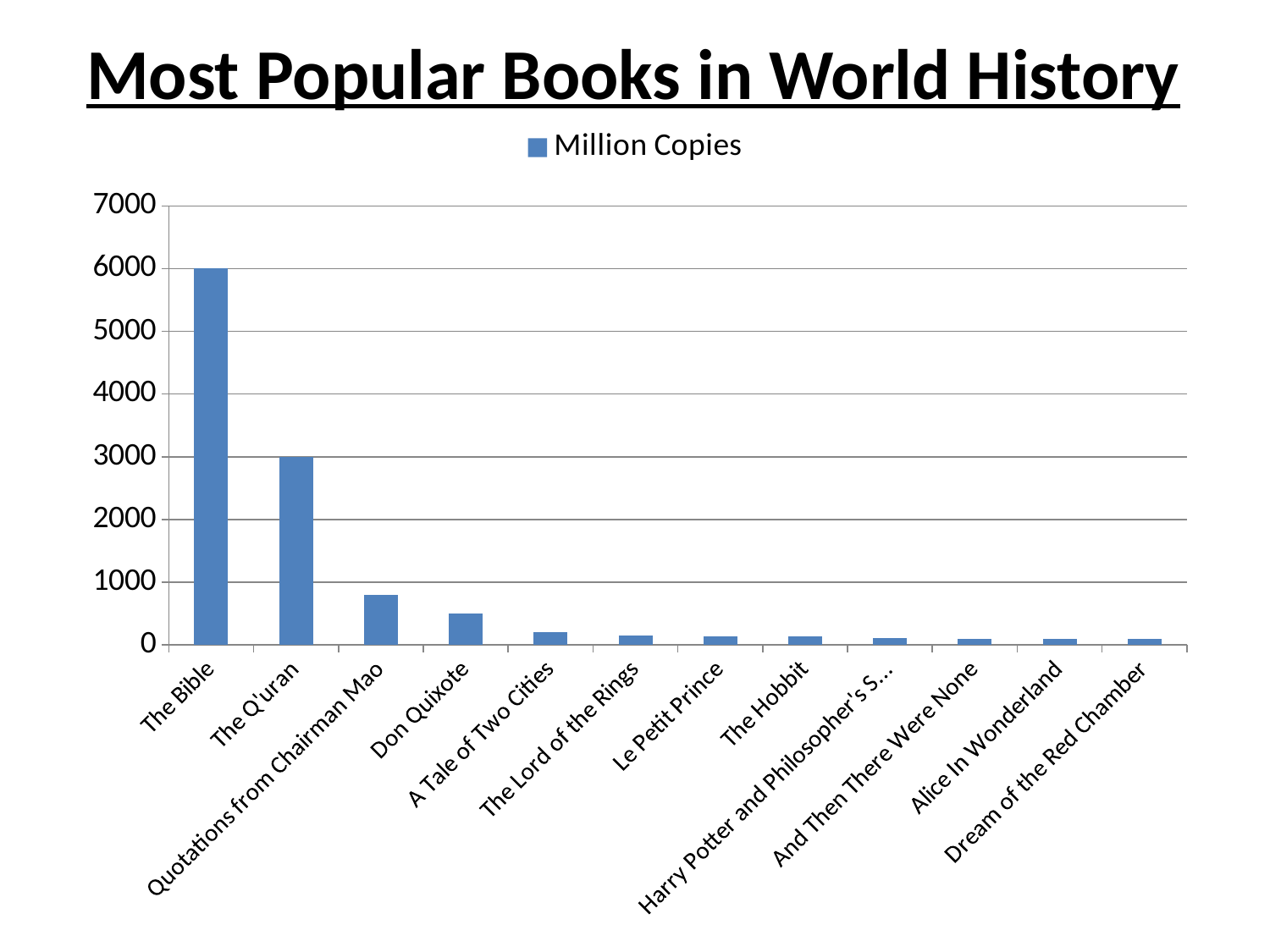
What is the value for The Q'uran? 3000 What is the title of the chart? Most Popular Books in World History How many books are shown on the x axis? 12 What series does the legend list? Million Copies Which has the larger value, Quotations from Chairman Mao or Don Quixote? Quotations from Chairman Mao Is the value for Quotations from Chairman Mao greater or less than 1000? less What kind of chart is shown on the slide? bar chart How many series does the legend list? 1 Which book has the highest value? The Bible Do the values rise or fall from left to right along the x axis? fall